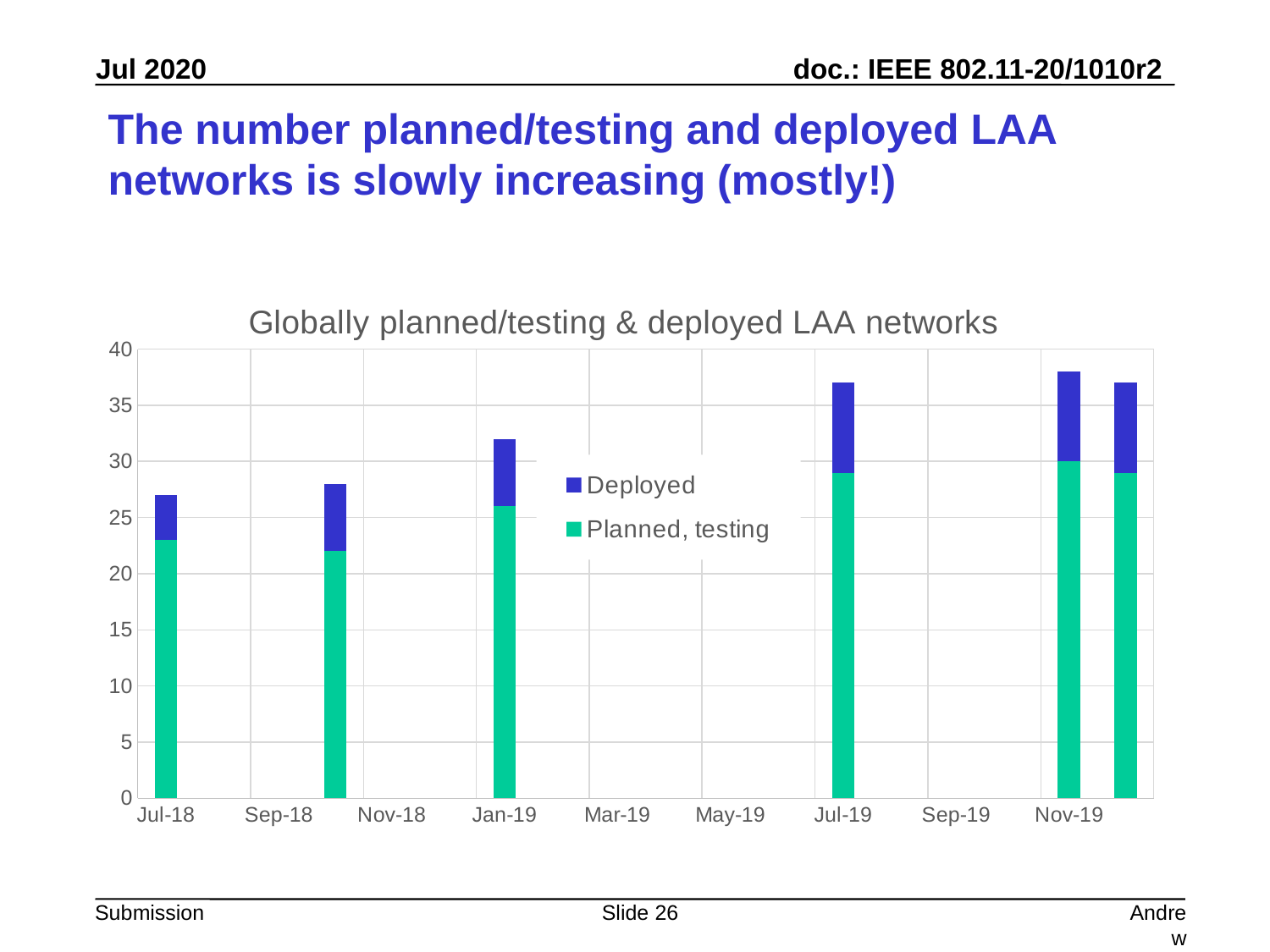
How many series does the legend list? 2 What are the two series named in the legend? Deployed; Planned, testing How many stacked bars are plotted in the chart? 6 Which bar has the larger total, Jan-19 or Jul-19? Jul-19 Is the total height of the Jul-19 bar greater or less than 35? greater Do the total bar heights generally rise or fall from Jul-18 to Nov-19? rise What kind of chart is shown on the slide? Stacked bar chart Is the total height of the Jul-18 bar greater or less than 25? greater What is the title of the chart? Globally planned/testing & deployed LAA networks Is the 'Planned, testing' value for Jul-18 greater or less than 20? greater